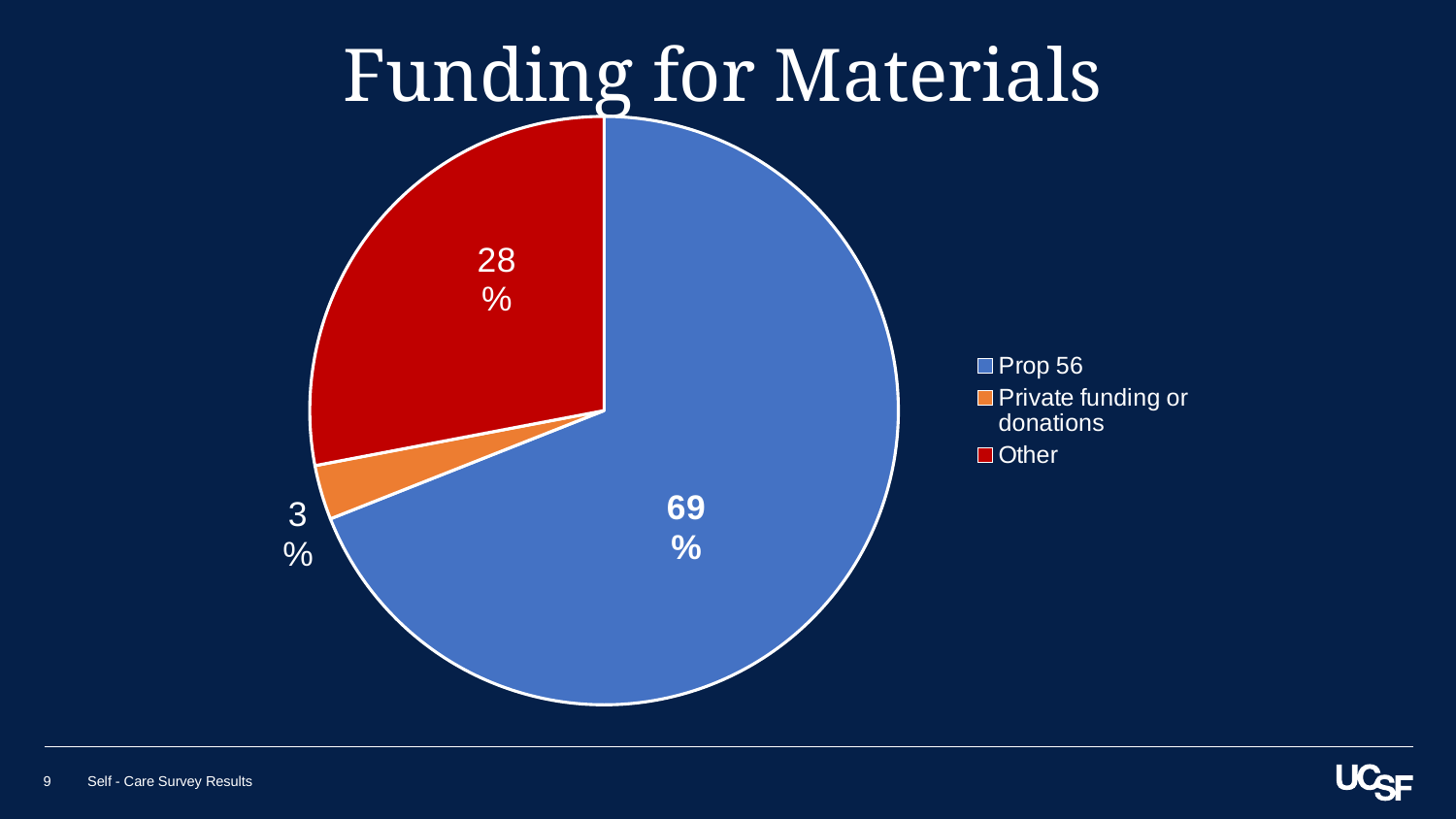
What share of the pie does Prop 56 represent? 69% Which is larger, the share for Other or the share for Private funding or donations? Other What share of the pie does Private funding or donations represent? 3% What is the difference in percentage points between Prop 56 and Other? 41 Which category has the largest slice of the pie? Prop 56 How many categories does the legend list? 3 Which category has the smallest slice of the pie? Private funding or donations What is the title of the chart? Funding for Materials What share of the pie does Other represent? 28% What colour is the slice for Other? red What is the difference in percentage points between Other and Private funding or donations? 25 What type of chart is shown on the slide? pie chart